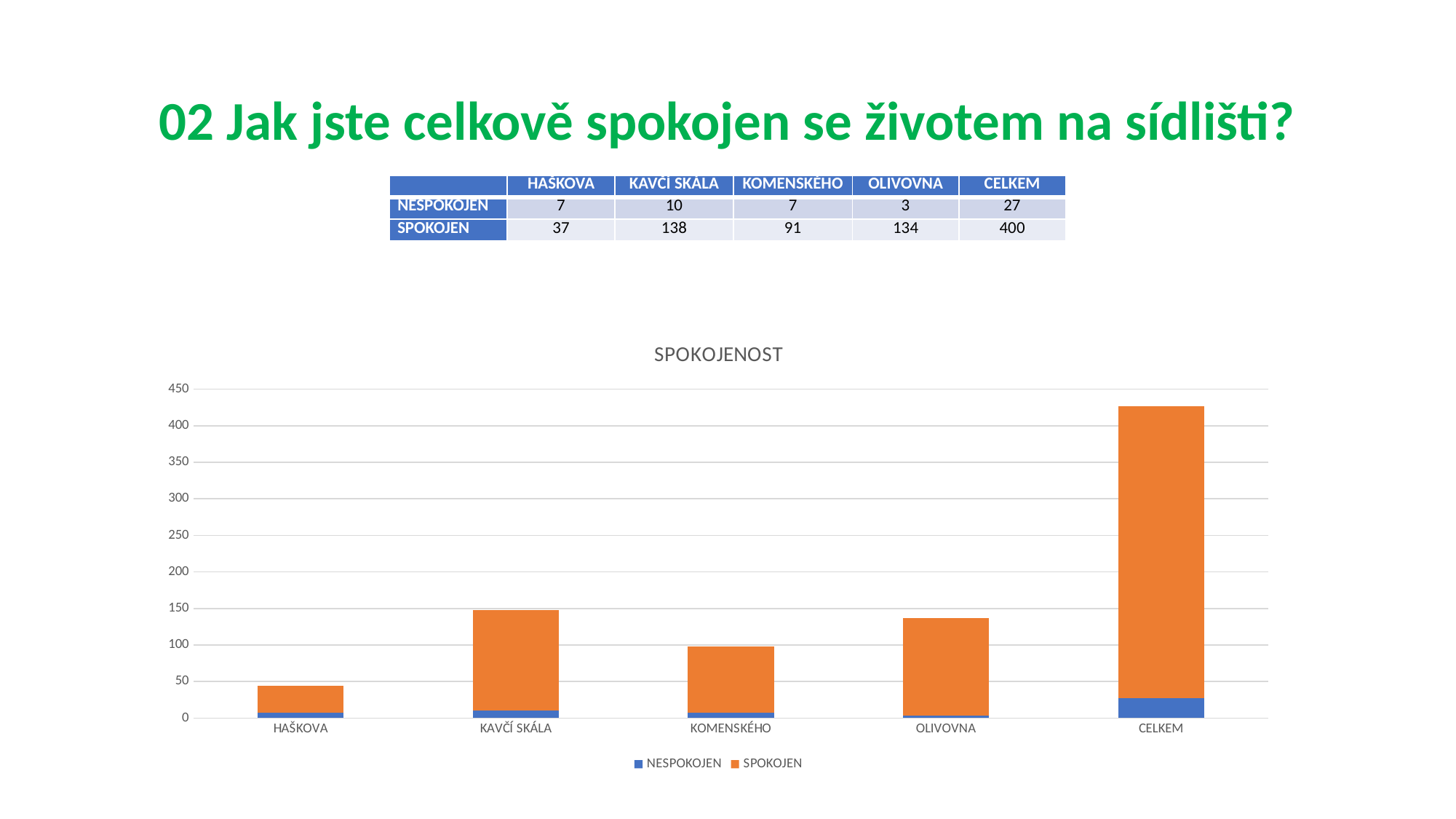
Which category has the lowest SPOKOJEN value? HAŠKOVA Which is larger, the SPOKOJEN value for KOMENSKÉHO or for OLIVOVNA? OLIVOVNA How many series does the chart legend list? 2 What type of chart is shown on the slide? Stacked bar chart What is the NESPOKOJEN value for OLIVOVNA? 3 What is the total height of the stacked bar for CELKEM? 427 How many categories are shown on the x axis of the chart? 5 What is the SPOKOJEN value for CELKEM? 400 Excluding CELKEM, which category has the highest NESPOKOJEN value? KAVČÍ SKÁLA What is the SPOKOJEN value for KAVČÍ SKÁLA? 138 What is the total height of the stacked bar for KAVČÍ SKÁLA? 148 What is the difference between the SPOKOJEN values for KAVČÍ SKÁLA and OLIVOVNA? 4